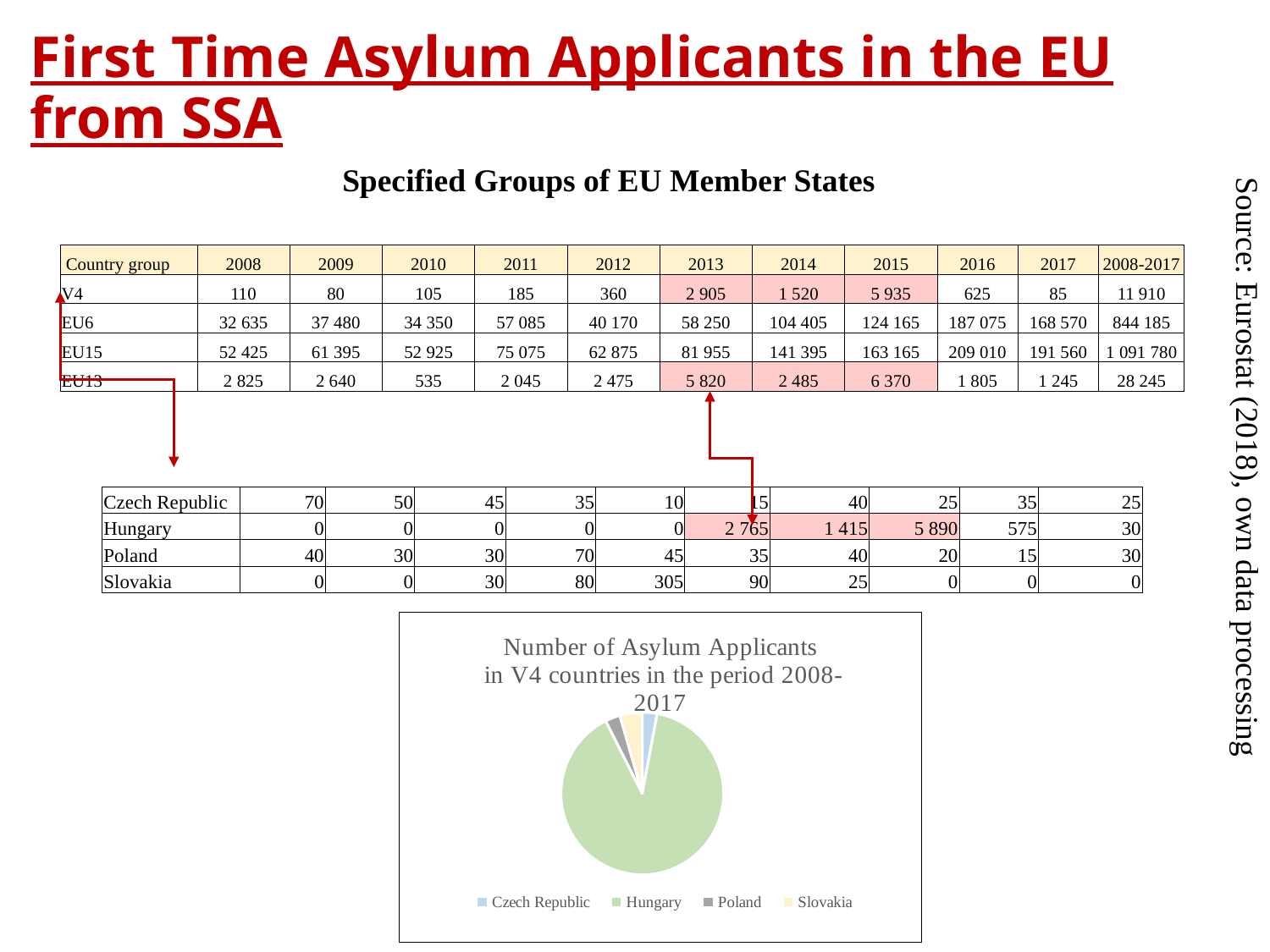
How many slices does the pie chart have? 4 What kind of chart is shown on the slide? pie chart Which countries are listed in the pie chart's legend? Czech Republic, Hungary, Poland, Slovakia Which country has the largest slice in the pie chart? Hungary In the pie chart, which slice is larger: Hungary or Czech Republic? Hungary What is the title of the pie chart? Number of Asylum Applicants in V4 countries in the period 2008-2017 In the pie chart, which slice is larger: Hungary or Poland? Hungary How many countries does the pie chart's legend list? 4